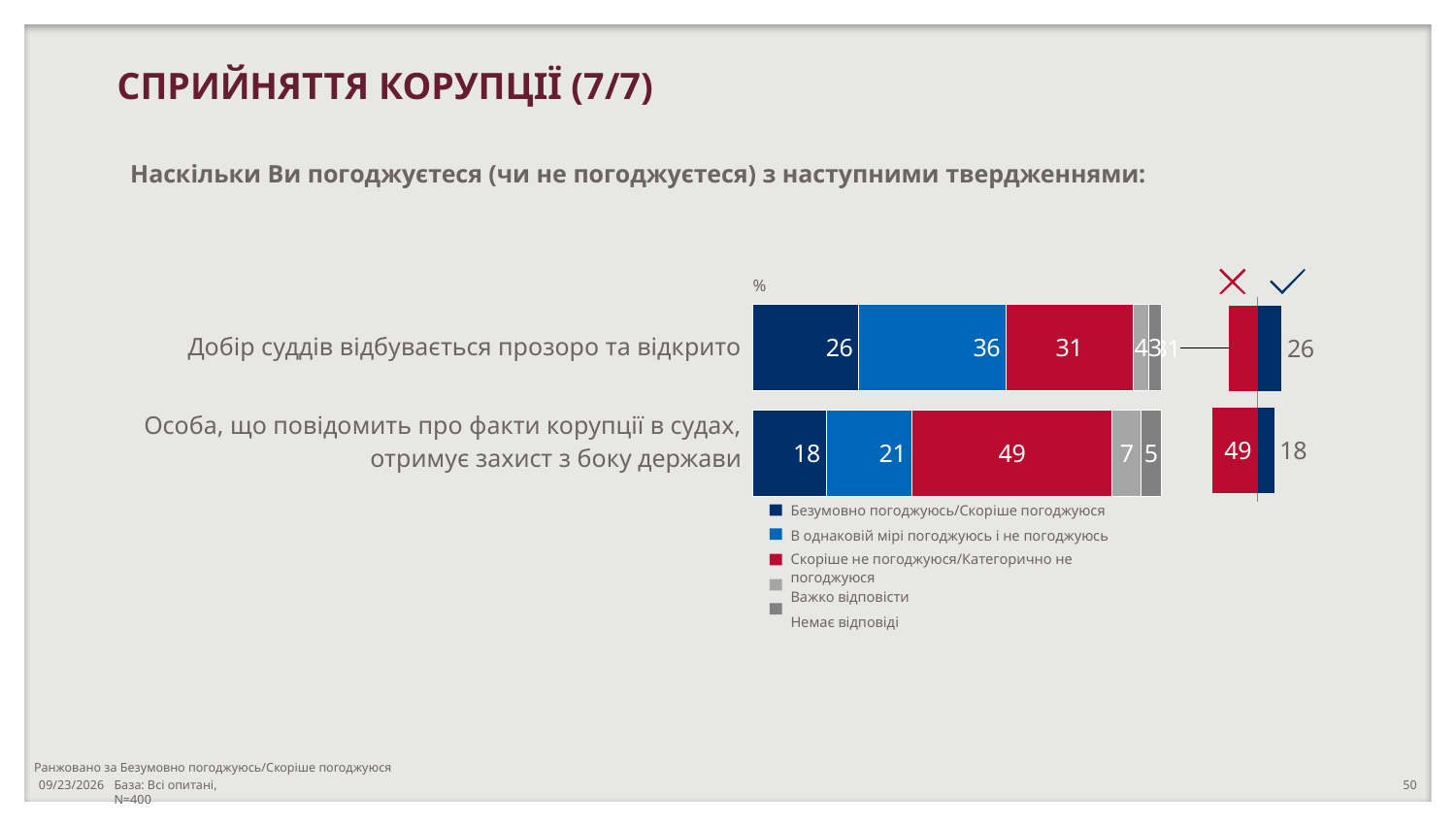
How many series does the legend list? 5 How many statements are shown in the chart? 2 What is the value for 'Важко відповісти' for the statement about a person reporting corruption in courts receiving state protection? 7 What is the value for 'В однаковій мірі погоджуюсь і не погоджуюсь' for the statement 'Добір суддів відбувається прозоро та відкрито'? 36 What is the value for 'Немає відповіді' for the statement 'Особа, що повідомить про факти корупції в судах, отримує захист з боку держави'? 5 What type of chart is shown on the slide? Stacked bar chart Which statement has the higher share of respondents who definitely or rather agree? Добір суддів відбувається прозоро та відкрито What percentage of respondents rather or categorically disagree (Скоріше не погоджуюся/Категорично не погоджуюся) that a person reporting corruption in courts receives state protection? 49 For the statement about state protection for a person reporting corruption in courts, what is the difference between the disagree share and the agree share? 31 What percentage of respondents definitely or rather agree (Безумовно погоджуюсь/Скоріше погоджуюся) that the selection of judges is transparent and open (Добір суддів відбувається прозоро та відкрито)? 26 What is the difference between the disagreement shares (Скоріше не погоджуюся/Категорично не погоджуюся) for the two statements? 18 Which colour represents 'Скоріше не погоджуюся/Категорично не погоджуюся' in the chart? Red